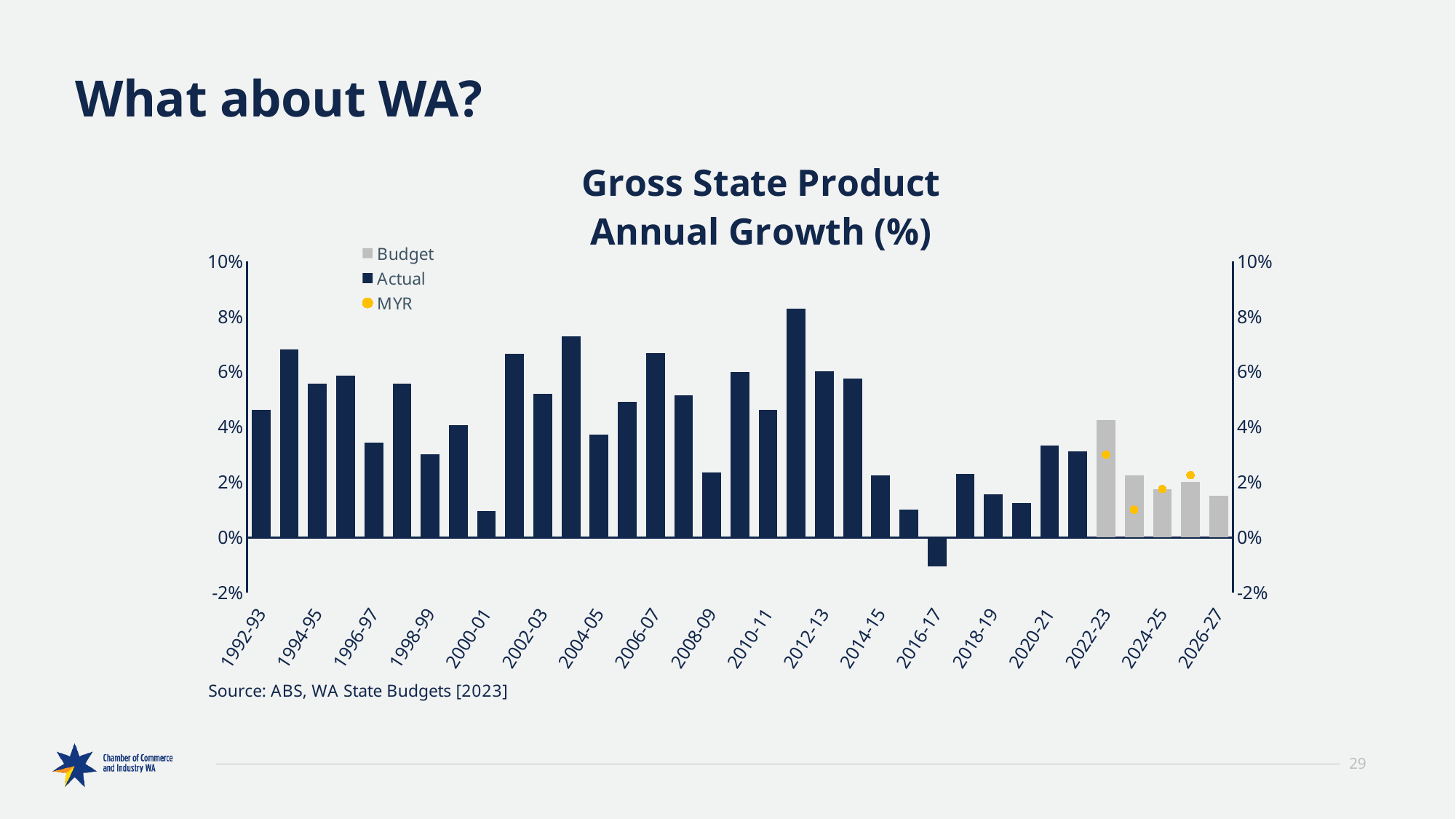
How many series does the legend list? 3 Which year has the lowest Gross State Product annual growth? 2016-17 What kind of chart is shown on the slide? Bar chart Which series is shown with yellow dots rather than bars? MYR Is the value for 2026-27 greater or less than 2%? less What is the title of the chart? Gross State Product Annual Growth (%) Which is larger, the value for 1994-95 or the value for 2000-01? 1994-95 Which year has the highest Gross State Product annual growth? 2011-12 How many year labels are shown on the x axis? 18 Is the value for 2016-17 greater or less than 0%? less Is the value for 2000-01 greater or less than 2%? less